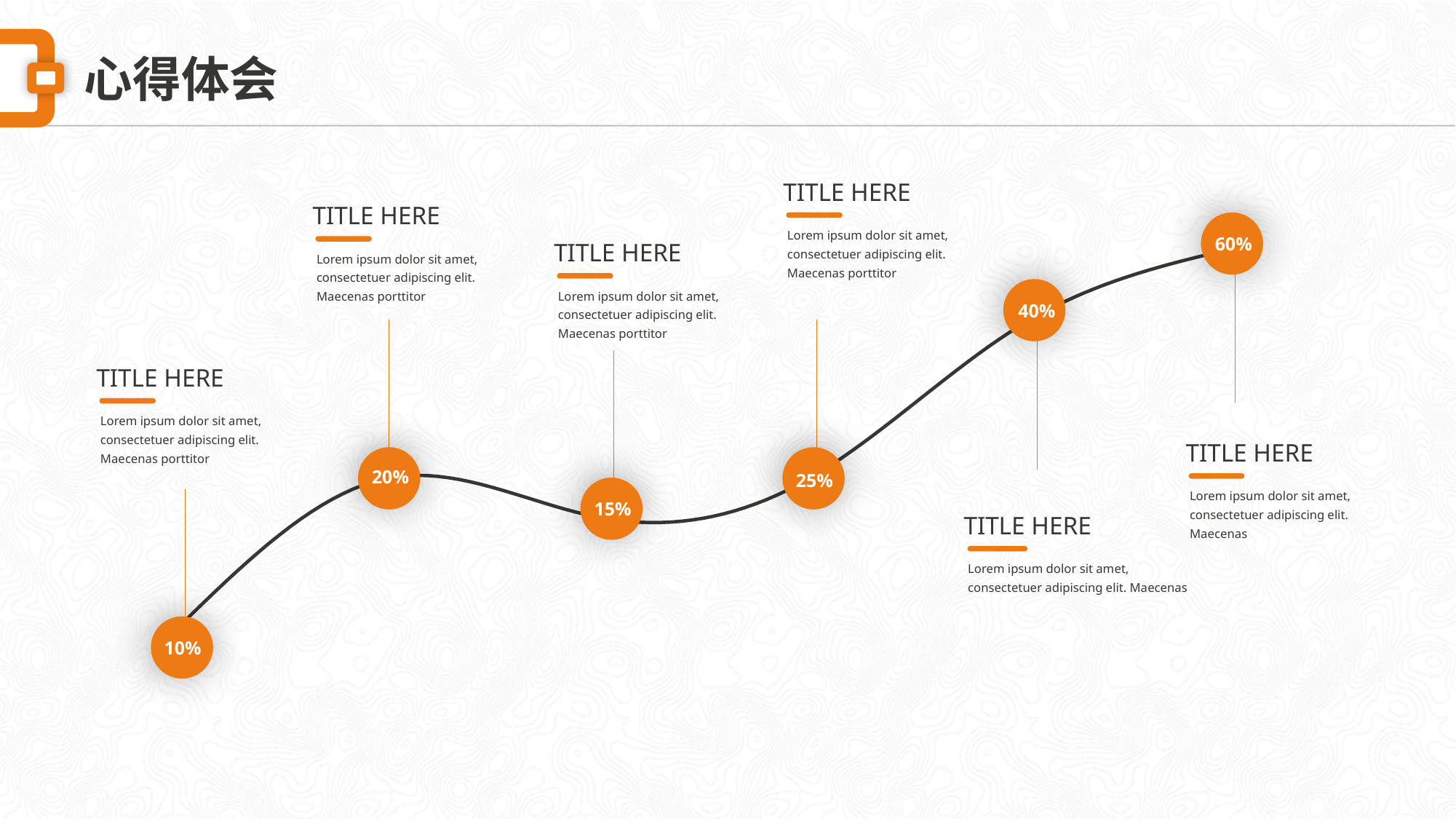
What colour are the data point markers on the line? orange What is the value of the first (leftmost) point on the line? 10% What kind of chart is shown on the slide? line chart Which is larger, the second point or the third point on the line? the second point (20%) What is the value of the fifth point from the left on the line? 40% What is the value of the third point from the left on the line? 15% What is the lowest value shown on the line? 10% What is the difference between the second point (20%) and the third point (15%)? 5% What is the highest value shown on the line? 60% Do the values generally rise or fall from left to right along the line? rise How many data points are plotted on the line? 6 What is the difference between the last point (60%) and the first point (10%)? 50%